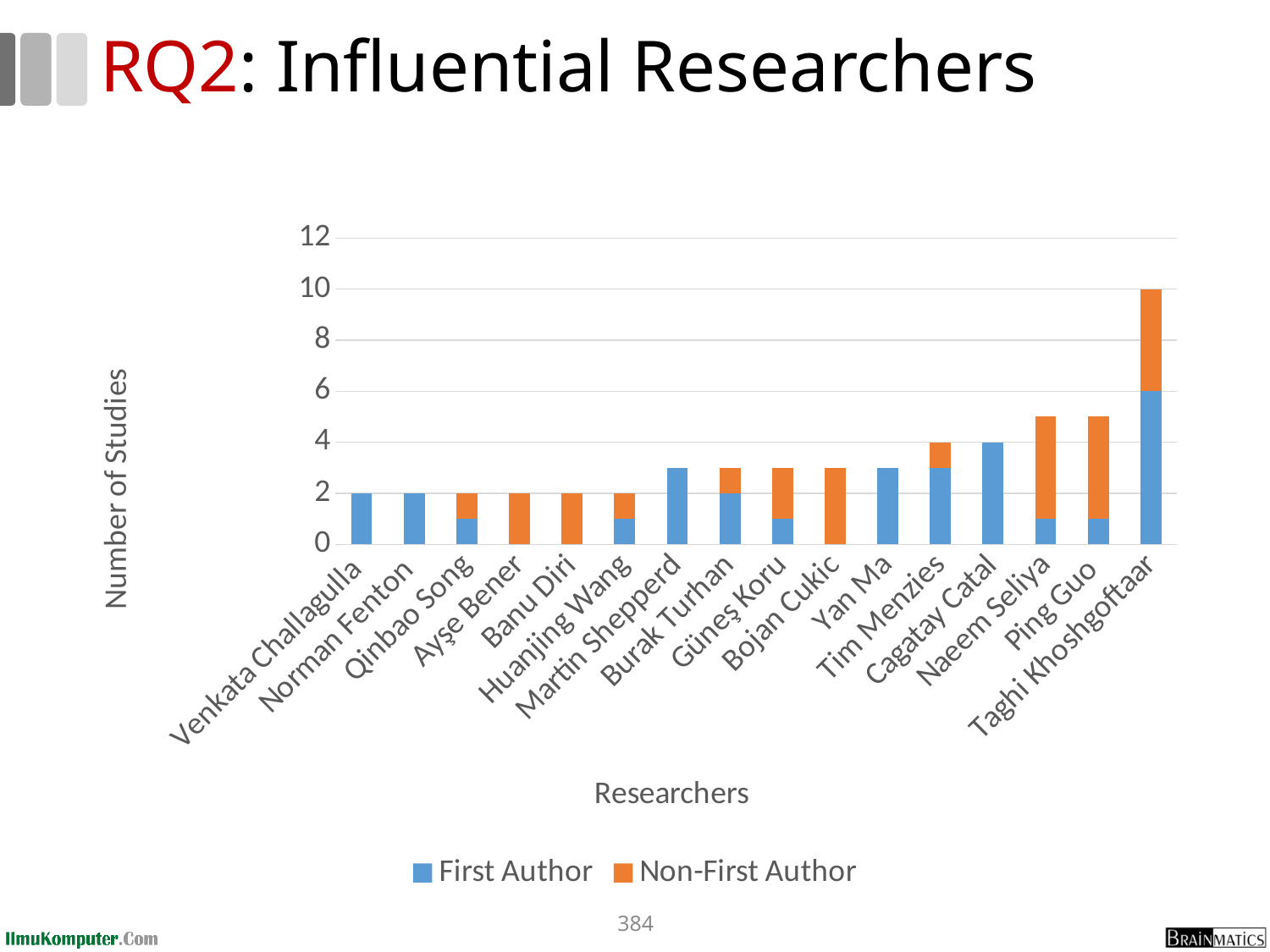
What kind of chart is shown on the slide? Stacked bar chart Which researcher has the highest total number of studies? Taghi Khoshgoftaar Is the total number of studies for Naeem Seliya greater or less than 4? greater What is the total number of studies for Norman Fenton? 2 What is the title of the y axis? Number of Studies How many First Author studies does Taghi Khoshgoftaar have? 6 How many series does the legend list? 2 What is the total number of studies for Taghi Khoshgoftaar? 10 Who has more total studies, Taghi Khoshgoftaar or Ping Guo? Taghi Khoshgoftaar How many researchers are shown on the x axis? 16 What is the total number of studies for Cagatay Catal? 4 Is the total number of studies for Martin Shepperd greater or less than 4? less